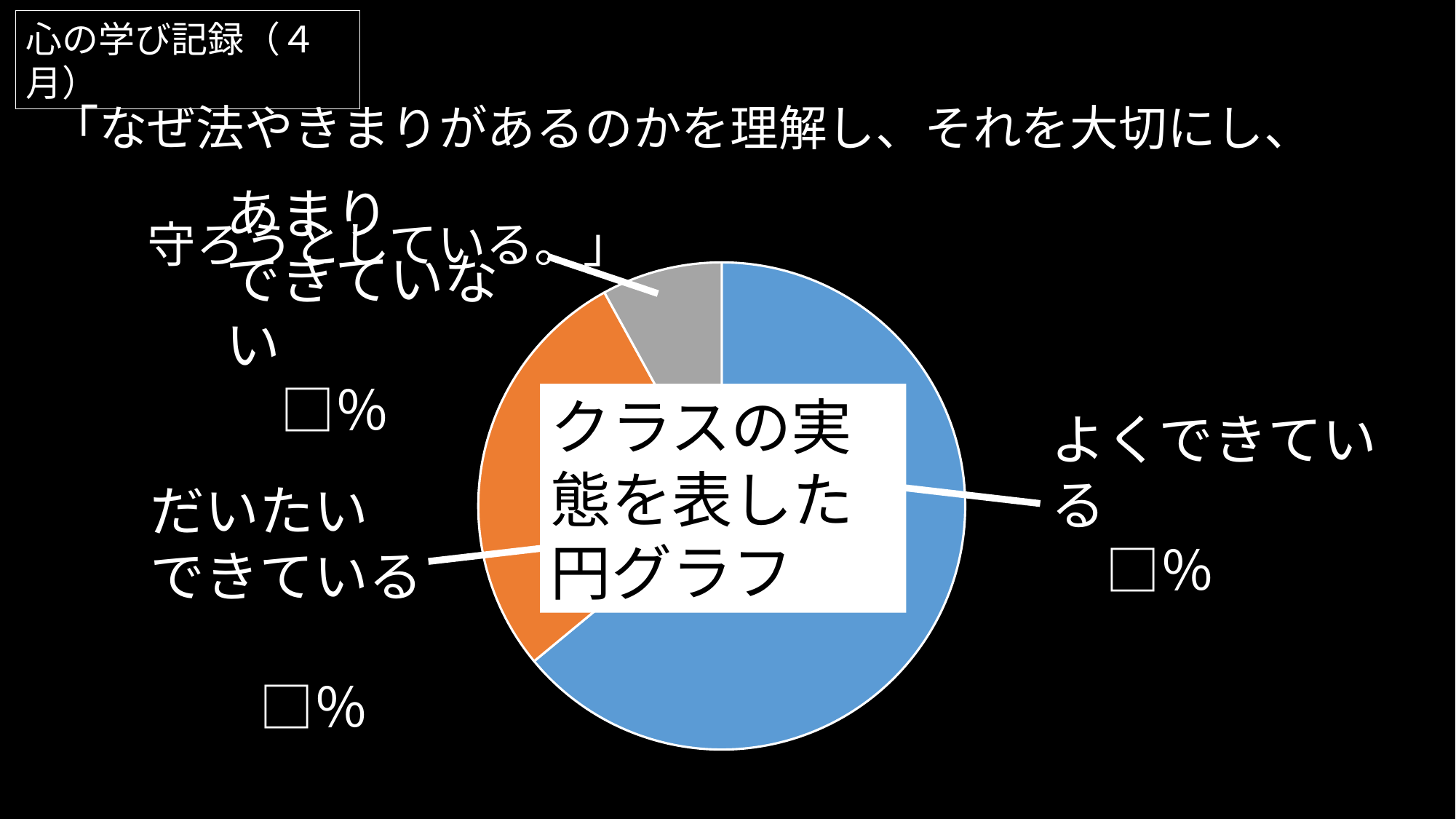
Which slice is larger, よくできている or だいたいできている? よくできている How many slices does the pie chart have? 3 What kind of chart is shown on the slide? pie chart What text is written in the box over the centre of the pie chart? クラスの実態を表した円グラフ Which category has the smallest slice of the pie chart? あまりできていない Which slice is larger, だいたいできている or あまりできていない? だいたいできている What colour is the slice for よくできている? blue Does the よくできている slice take up more or less than half of the pie? more Which category has the largest slice of the pie chart? よくできている